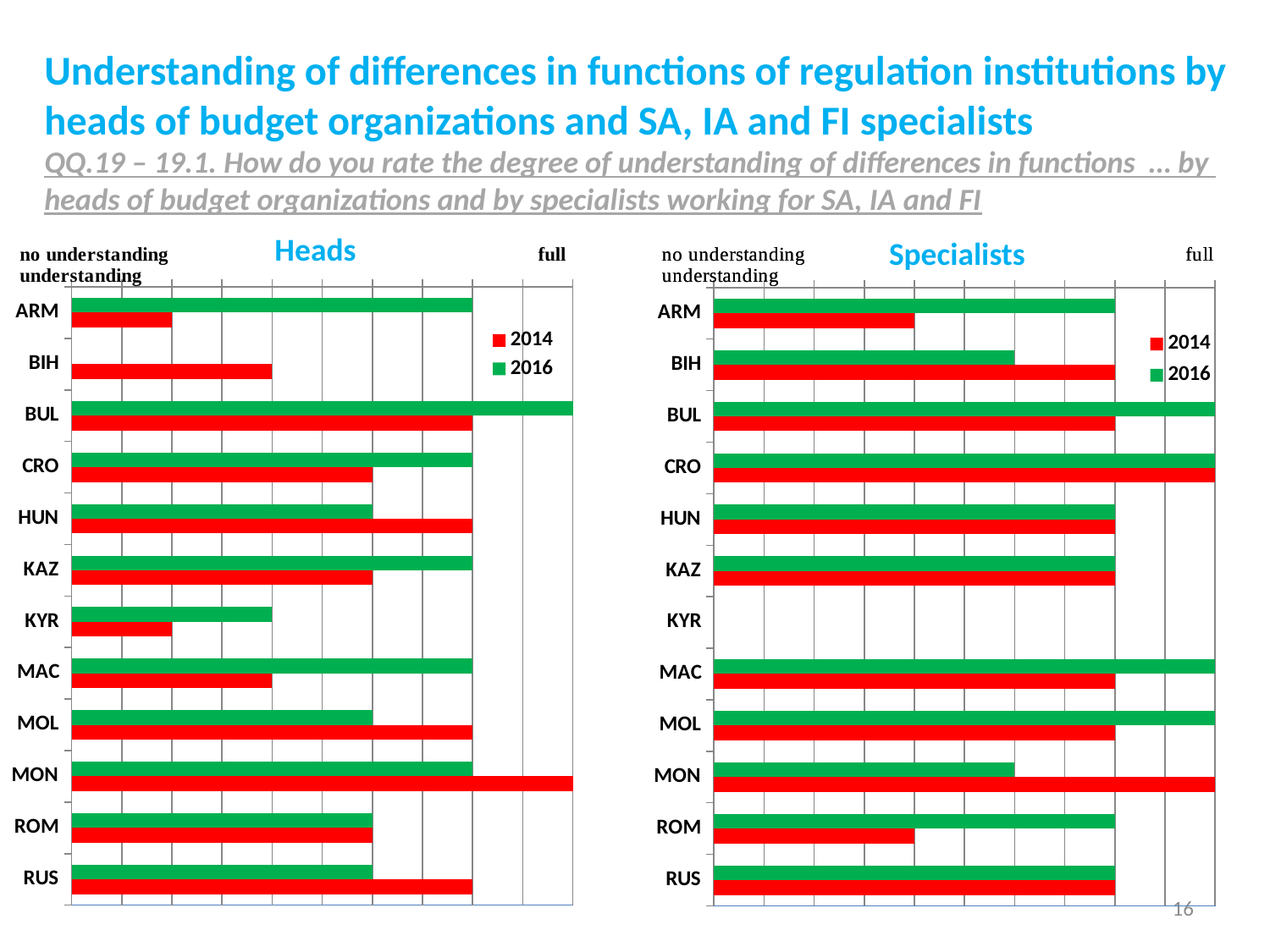
How many series does the legend of the Specialists chart list? 2 In the Heads chart, which country has the longest 2014 bar? MON In the Heads chart, which country has the shortest visible 2016 bar? KYR What kind of chart is the Heads chart? bar chart Which colour represents the 2014 series in the Heads chart? red In the Specialists chart, is the BIH value larger for 2014 or 2016? 2014 In the Heads chart, which country has the longest 2016 bar? BUL In the Heads chart, is the ARM value larger for 2014 or 2016? 2016 How many country categories are shown on the Heads chart? 12 In the Specialists chart, is the ROM value larger for 2014 or 2016? 2016 In the Specialists chart, which country has no bars plotted? KYR